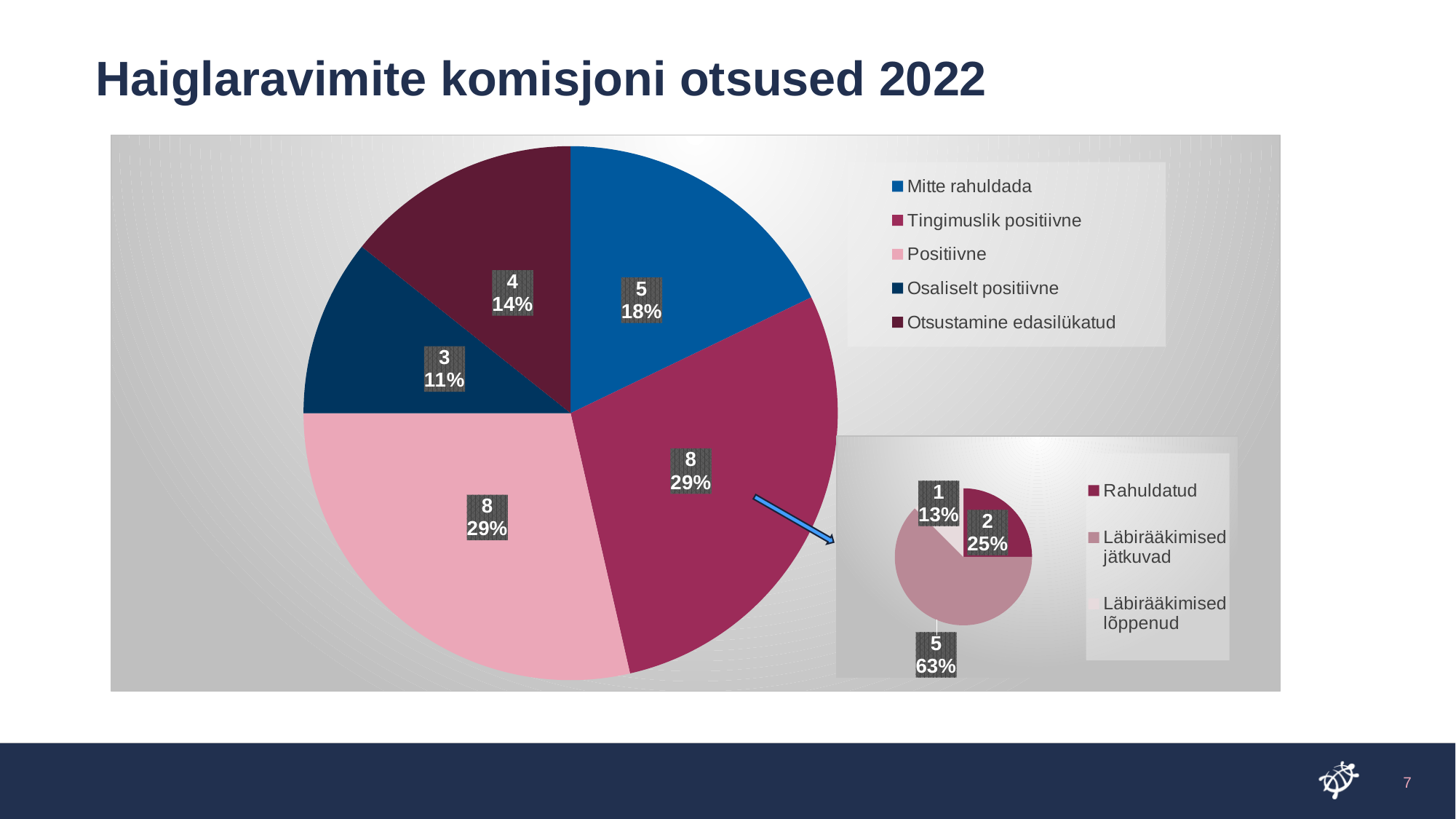
How many categories does the large pie chart on the left have? 5 In the large pie chart on the left, which is larger: Mitte rahuldada or Otsustamine edasilükatud? Mitte rahuldada In the small pie chart on the right, what percentage share does Läbirääkimised jätkuvad have? 63% In the large pie chart on the left, what is the difference between the counts for Mitte rahuldada and Osaliselt positiivne? 2 In the small pie chart on the right, which category has the largest slice? Läbirääkimised jätkuvad In the large pie chart on the left, what percentage share does Osaliselt positiivne have? 11% What type of chart is the large chart on the left? Pie chart In the large pie chart on the left, which category has the smallest slice? Osaliselt positiivne In the large pie chart on the left, what is the count for Mitte rahuldada? 5 In the small pie chart on the right, what is the count for Rahuldatud? 2 In the large pie chart on the left, what is the count for Otsustamine edasilükatud? 4 How many entries does the legend of the small pie chart on the right list? 3